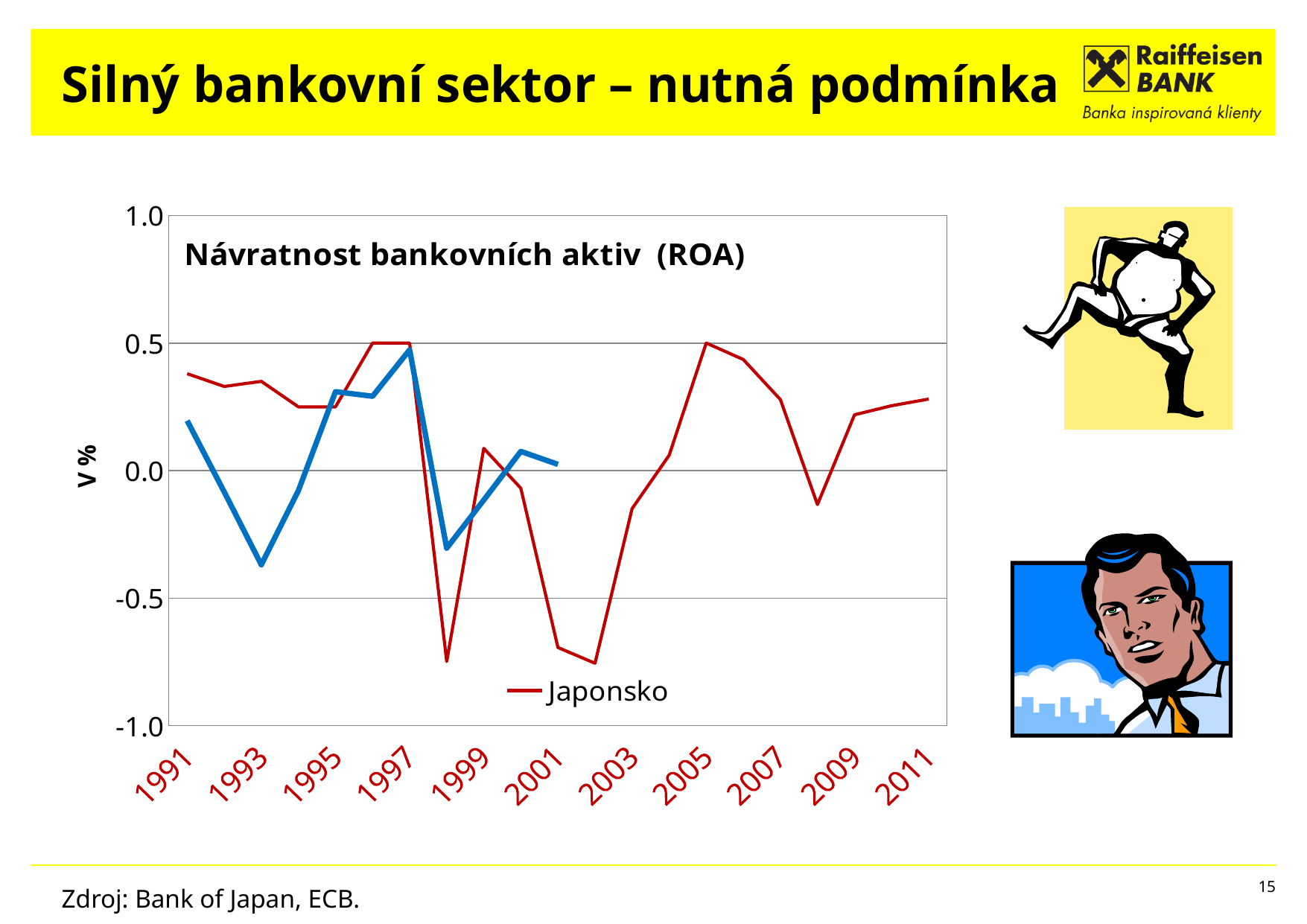
How many series does the chart legend list? 1 Does the Japonsko line rise or fall between 2002 and 2005? rise What kind of chart is shown on the slide? line chart How many year labels are shown on the x axis of the chart? 11 Is the value for Japonsko in 1998 greater or less than -0.5? less Which is larger for Japonsko: the value in 1991 or the value in 1998? 1991 Is the value for Japonsko in 2002 greater or less than -0.5? less What is the title of the chart? Návratnost bankovních aktiv (ROA) Which is larger for Japonsko: the value in 2005 or the value in 2008? 2005 What is the label on the vertical axis of the chart? V % Is the value for Japonsko in 1991 greater or less than 0.0? greater